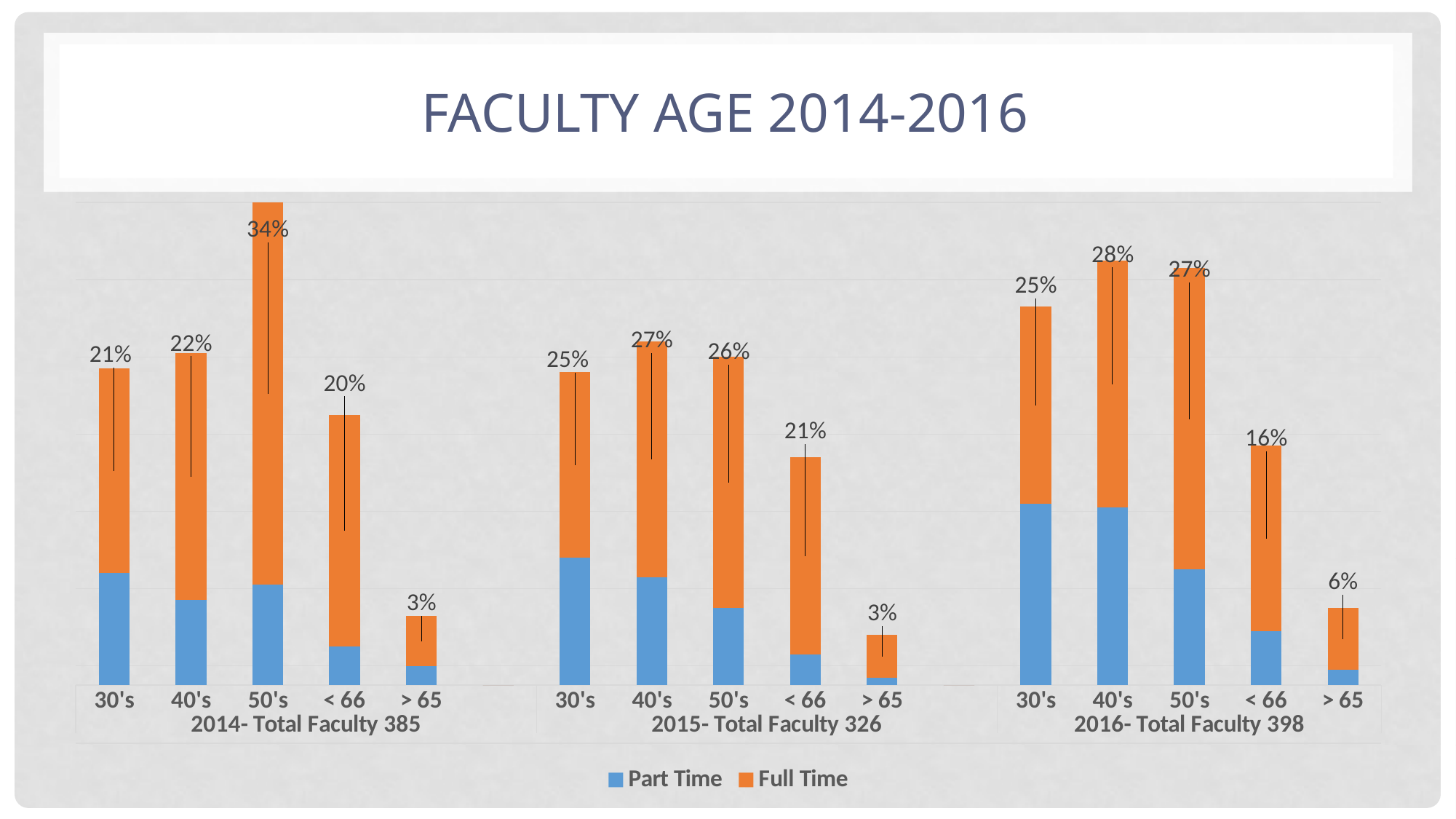
What percentage is shown for the > 65 age group in 2015? 3% In 2015, which has the larger percentage, the 40's group or the 50's group? 40's Which age group has the lowest percentage in 2015? > 65 Is the > 65 percentage larger in 2014 or in 2016? 2016 What is the difference between the 50's and > 65 percentages in 2014? 31 percentage points What kind of chart is shown on the slide? Stacked bar chart What percentage is shown for the < 66 age group in 2016? 16% Which age group has the highest percentage in 2014? 50's What total faculty number is given for 2015? 326 How many series does the legend list? 2 What percentage is shown for the 50's age group in 2014? 34% How many age categories are shown for each year? 5